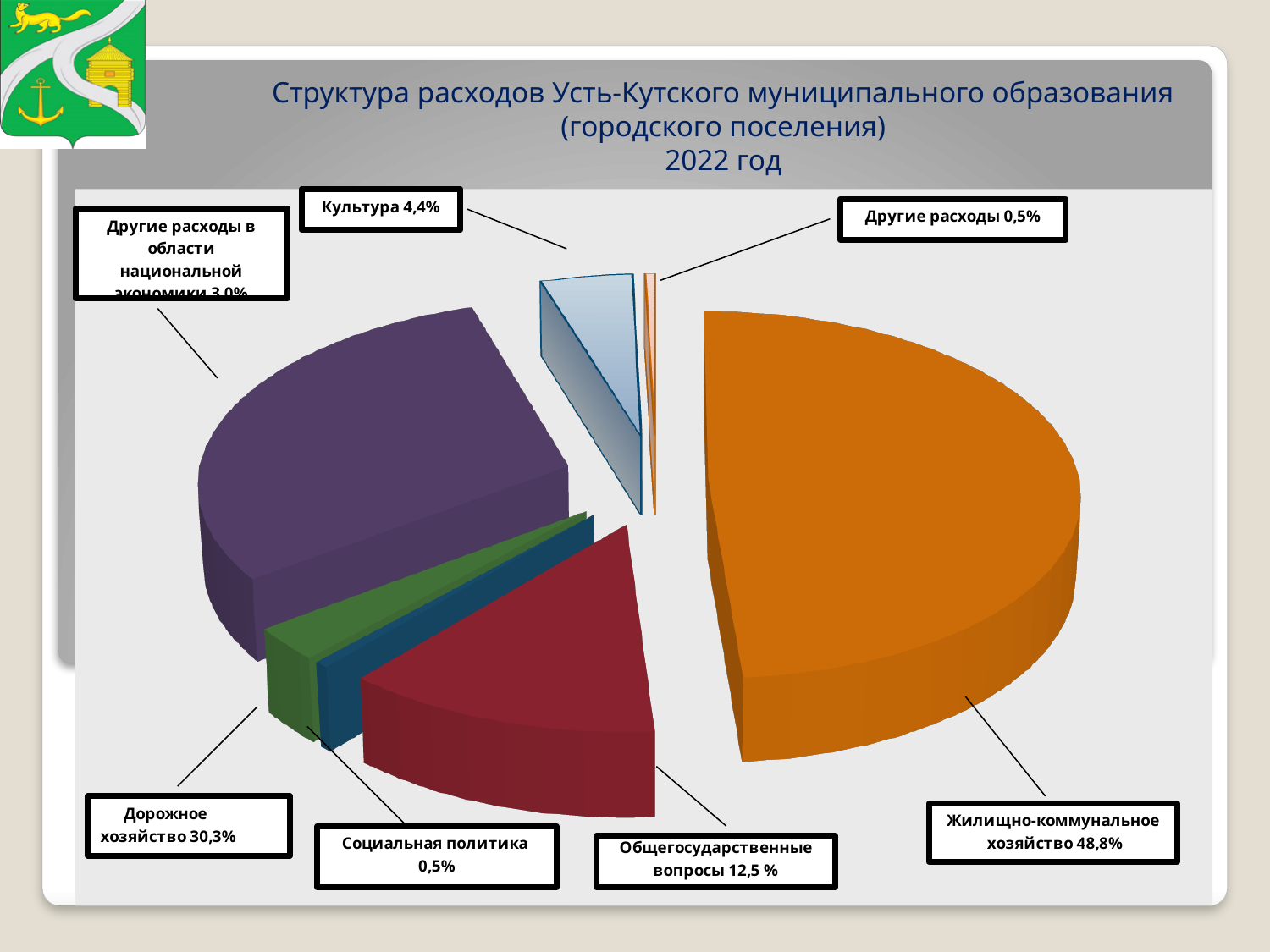
How many categories are shown in the pie chart? 7 Which category has the largest share of expenditures? Жилищно-коммунальное хозяйство What year does the chart title refer to? 2022 год Which is larger, the share for Дорожное хозяйство or the share for Общегосударственные вопросы? Дорожное хозяйство What colour is the slice for Жилищно-коммунальное хозяйство? orange What is the difference between the shares of Жилищно-коммунальное хозяйство and Дорожное хозяйство? 18,5% What share of expenditures is Культура? 4,4% What share of expenditures is Дорожное хозяйство? 30,3% What share of expenditures is Жилищно-коммунальное хозяйство? 48,8% What kind of chart is shown on the slide? pie chart What share of expenditures is Социальная политика? 0,5% What share of expenditures is Общегосударственные вопросы? 12,5 %